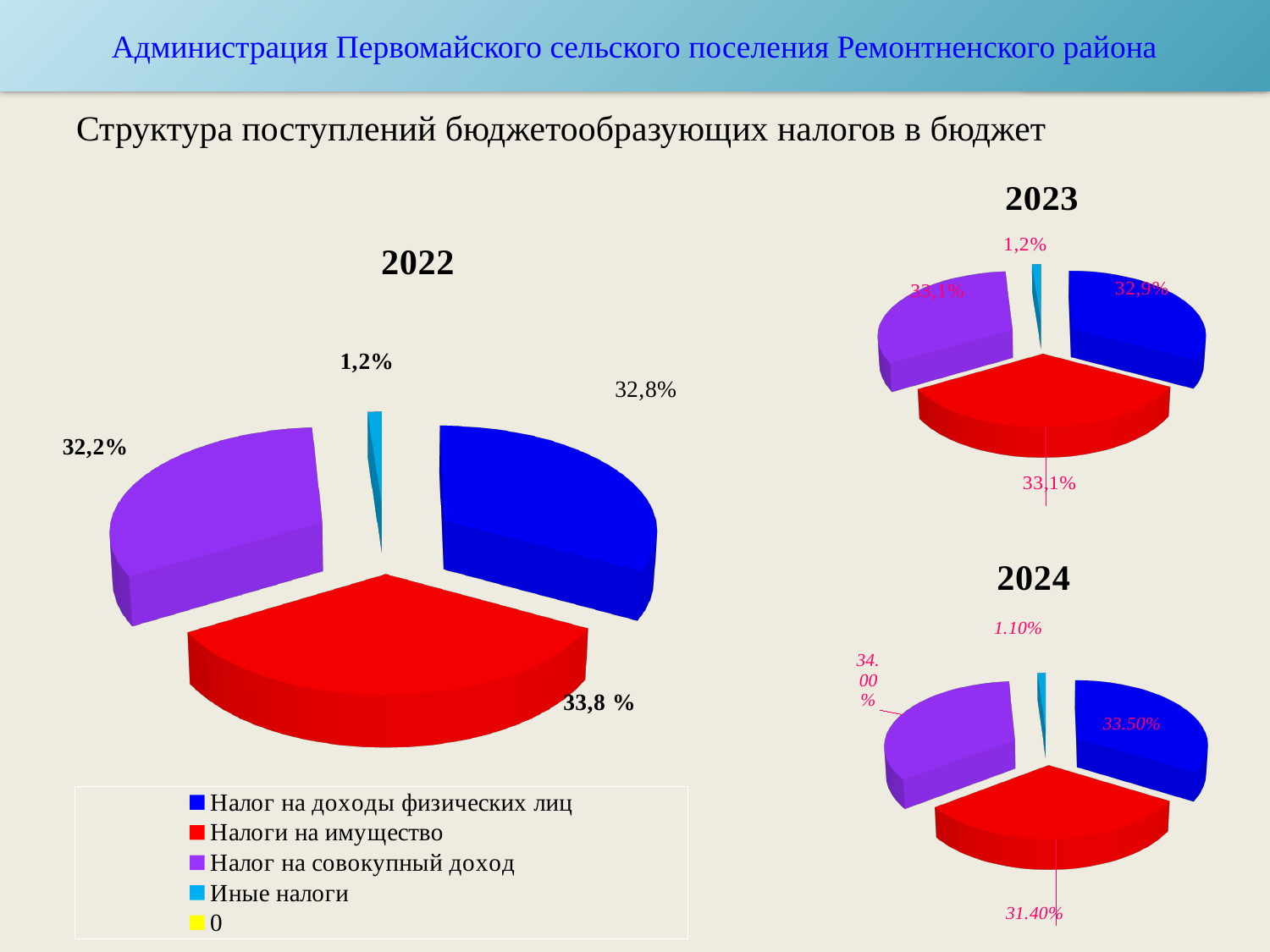
On the 2022 pie chart, which category has the smallest slice? Иные налоги On the 2022 pie chart, which category has the largest slice? Налоги на имущество What type of chart is used for the 2022, 2023 and 2024 data on this slide? Pie chart On the 2024 pie chart, which is larger: Налог на доходы физических лиц or Налоги на имущество? Налог на доходы физических лиц On the 2023 pie chart, which category has the smallest slice? Иные налоги On the 2024 pie chart, what share is shown for Налог на совокупный доход? 34.00% On the 2022 pie chart, what share is shown for Налоги на имущество? 33,8 % How many entries does the legend on the slide list? 5 On the 2023 pie chart, what share is shown for Налог на доходы физических лиц? 32,9% On the 2022 pie chart, what is the difference between the shares of Налог на доходы физических лиц and Налог на совокупный доход? 0,6% On the 2022 pie chart, what share is shown for Иные налоги? 1,2% On the 2024 pie chart, what share is shown for Налоги на имущество? 31.40%